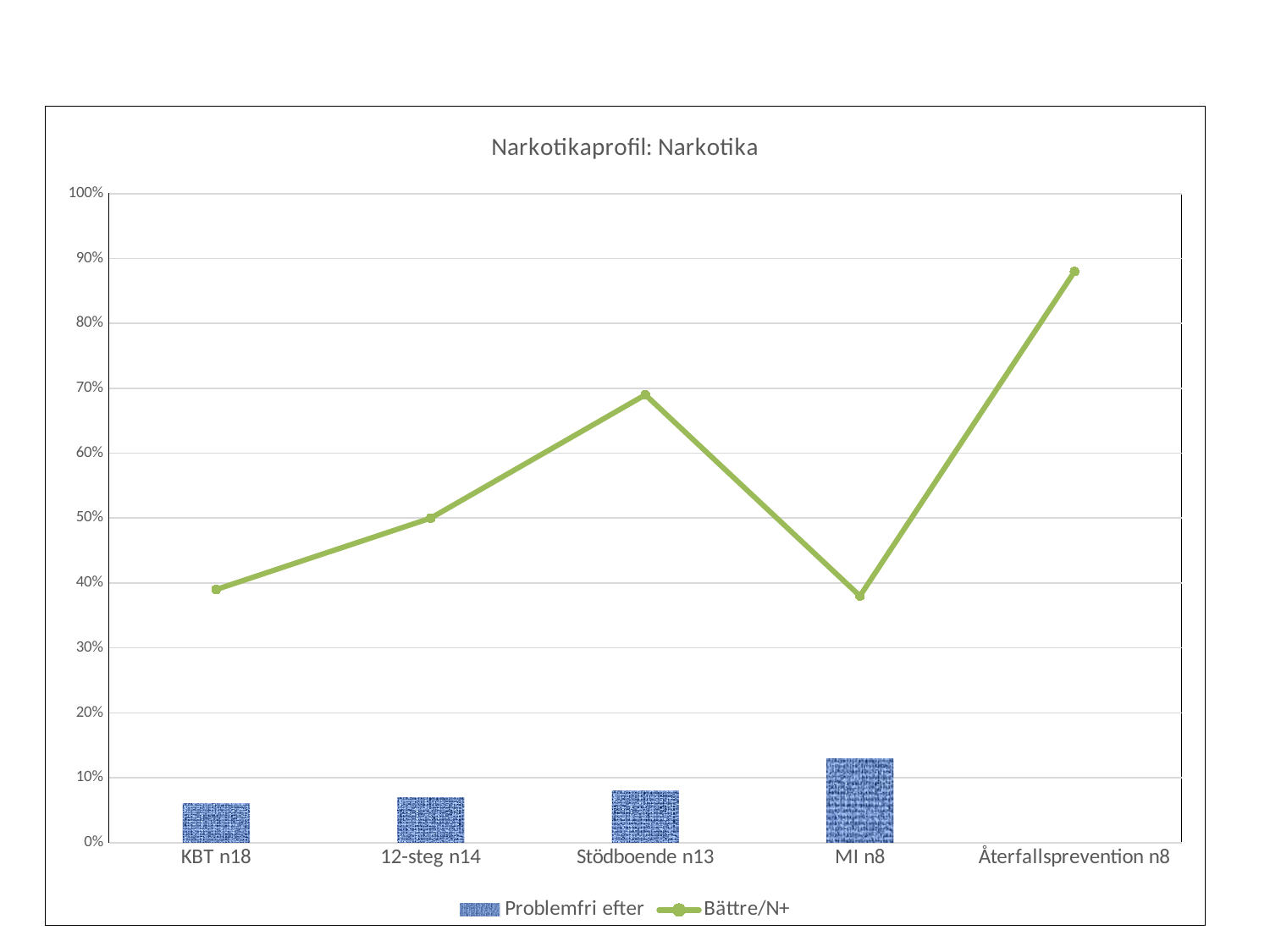
How many series does the legend list? 2 Is the Bättre/N+ value for Återfallsprevention n8 greater or less than 80%? greater How many categories are shown on the x axis? 5 Which series is drawn as a line? Bättre/N+ What is the title of the chart? Narkotikaprofil: Narkotika Which category has the highest Problemfri efter value? MI n8 Which has the larger Bättre/N+ value, Stödboende n13 or 12-steg n14? Stödboende n13 What kind of chart is shown on the slide? A combined bar and line chart Which category has the highest Bättre/N+ value? Återfallsprevention n8 What is the Bättre/N+ value for 12-steg n14? 50% Is the Bättre/N+ value for MI n8 greater or less than 50%? less Is the Bättre/N+ value for Stödboende n13 greater or less than 60%? greater